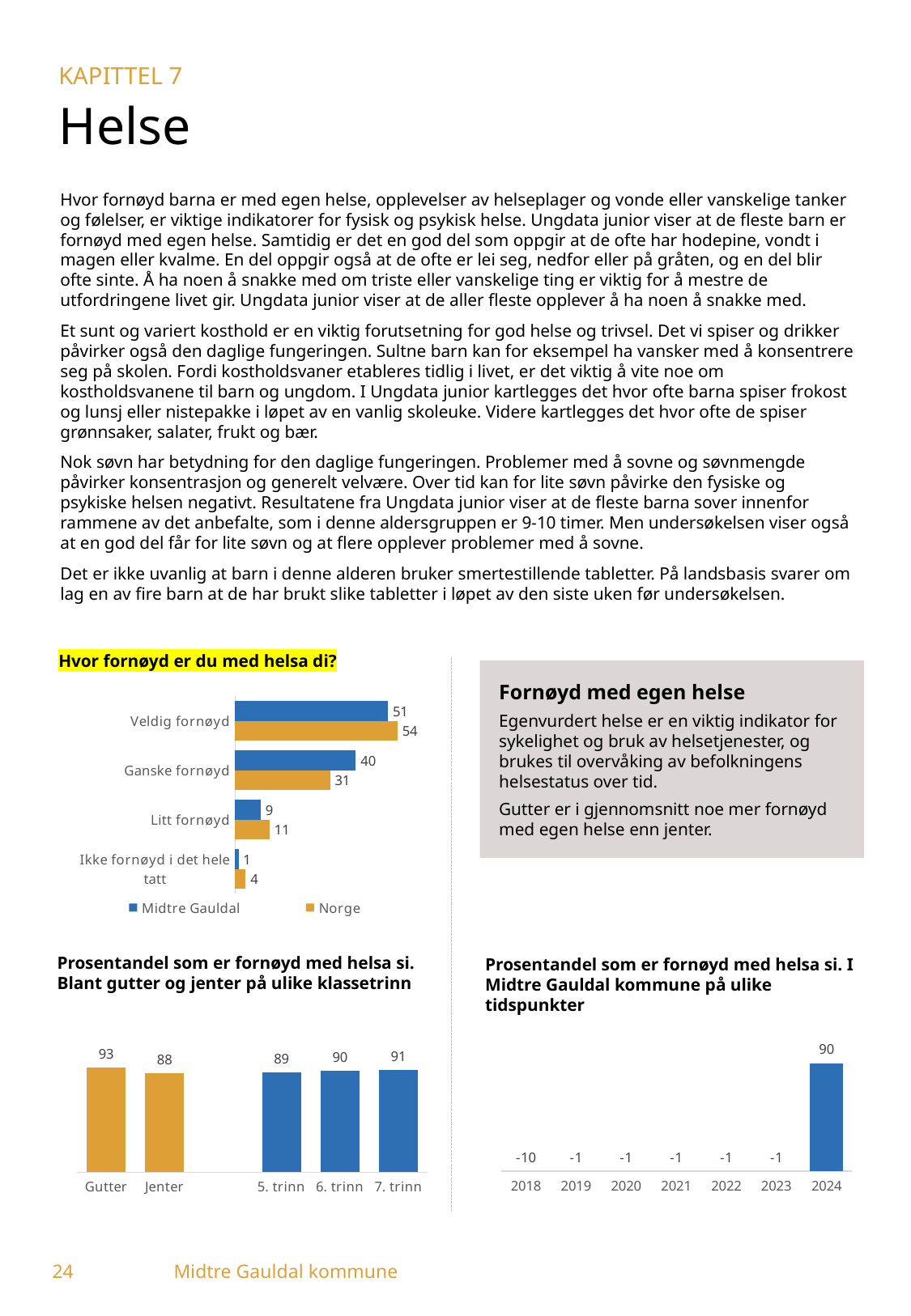
In the chart 'Hvor fornøyd er du med helsa di?', how many series does the legend list? 2 In the chart 'Hvor fornøyd er du med helsa di?', how many categories are shown? 4 What kind of chart is 'Hvor fornøyd er du med helsa di?'? Bar chart In the chart 'Prosentandel som er fornøyd med helsa si. Blant gutter og jenter på ulike klassetrinn', what is the difference between Gutter and Jenter? 5 In the chart 'Hvor fornøyd er du med helsa di?', what is the difference between the Midtre Gauldal and Norge values for 'Ganske fornøyd'? 9 In the chart 'Prosentandel som er fornøyd med helsa si. I Midtre Gauldal kommune på ulike tidspunkter', what is the value for 2024? 90 In the chart 'Hvor fornøyd er du med helsa di?', what is the value for Norge in the 'Ganske fornøyd' category? 31 In the chart 'Hvor fornøyd er du med helsa di?', what is the value for Midtre Gauldal in the 'Veldig fornøyd' category? 51 In the chart 'Prosentandel som er fornøyd med helsa si. Blant gutter og jenter på ulike klassetrinn', do the values rise or fall from 5. trinn to 7. trinn? Rise In the chart 'Prosentandel som er fornøyd med helsa si. Blant gutter og jenter på ulike klassetrinn', what is the value for Gutter? 93 In the chart 'Hvor fornøyd er du med helsa di?', which is larger for 'Litt fornøyd': Midtre Gauldal or Norge? Norge In the chart 'Prosentandel som er fornøyd med helsa si. Blant gutter og jenter på ulike klassetrinn', which category has the lowest value? Jenter